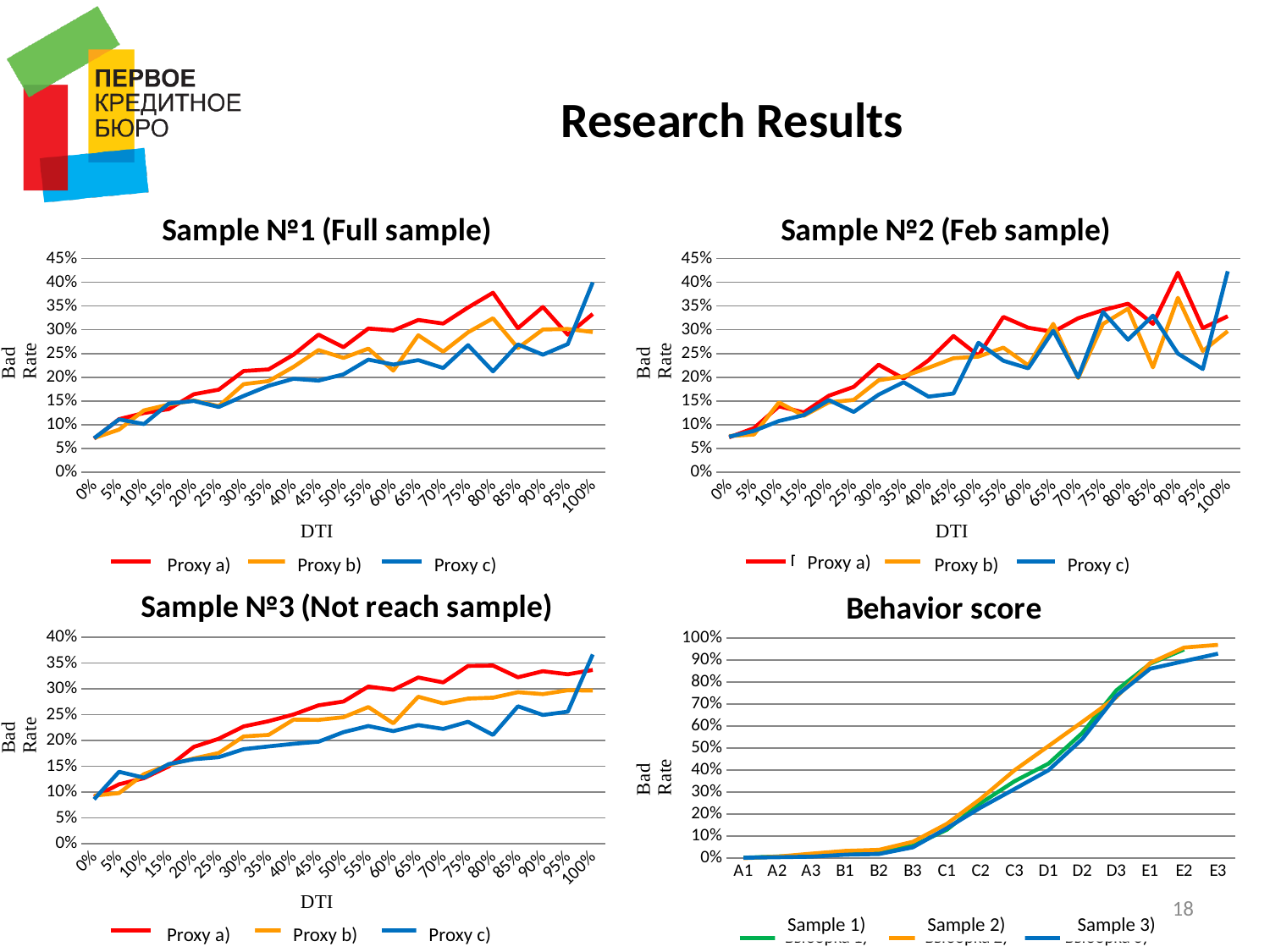
What is the x-axis label of the 'Sample №2 (Feb sample)' chart? DTI How many categories are on the x axis of the 'Behavior score' chart? 15 In the 'Sample №3 (Not reach sample)' chart, is the value for Proxy c) at 80% DTI greater or less than 25%? less In the 'Behavior score' chart, which is larger at D1: Sample 2) or Sample 3)? Sample 2) In the 'Sample №1 (Full sample)' chart, does the Bad Rate for Proxy a) generally rise or fall as DTI increases? rise In the 'Behavior score' chart, is the value for Sample 2) at E3 greater or less than 90%? greater How many series does the legend of the 'Sample №1 (Full sample)' chart list? 3 In the 'Sample №2 (Feb sample)' chart, is the value for Proxy c) at 100% DTI greater or less than 40%? greater How many DTI points are plotted along the x axis of the 'Sample №1 (Full sample)' chart? 21 In the 'Sample №3 (Not reach sample)' chart, which is larger at 80% DTI: Proxy a) or Proxy c)? Proxy a) What kind of chart is the 'Sample №1 (Full sample)' chart? line chart